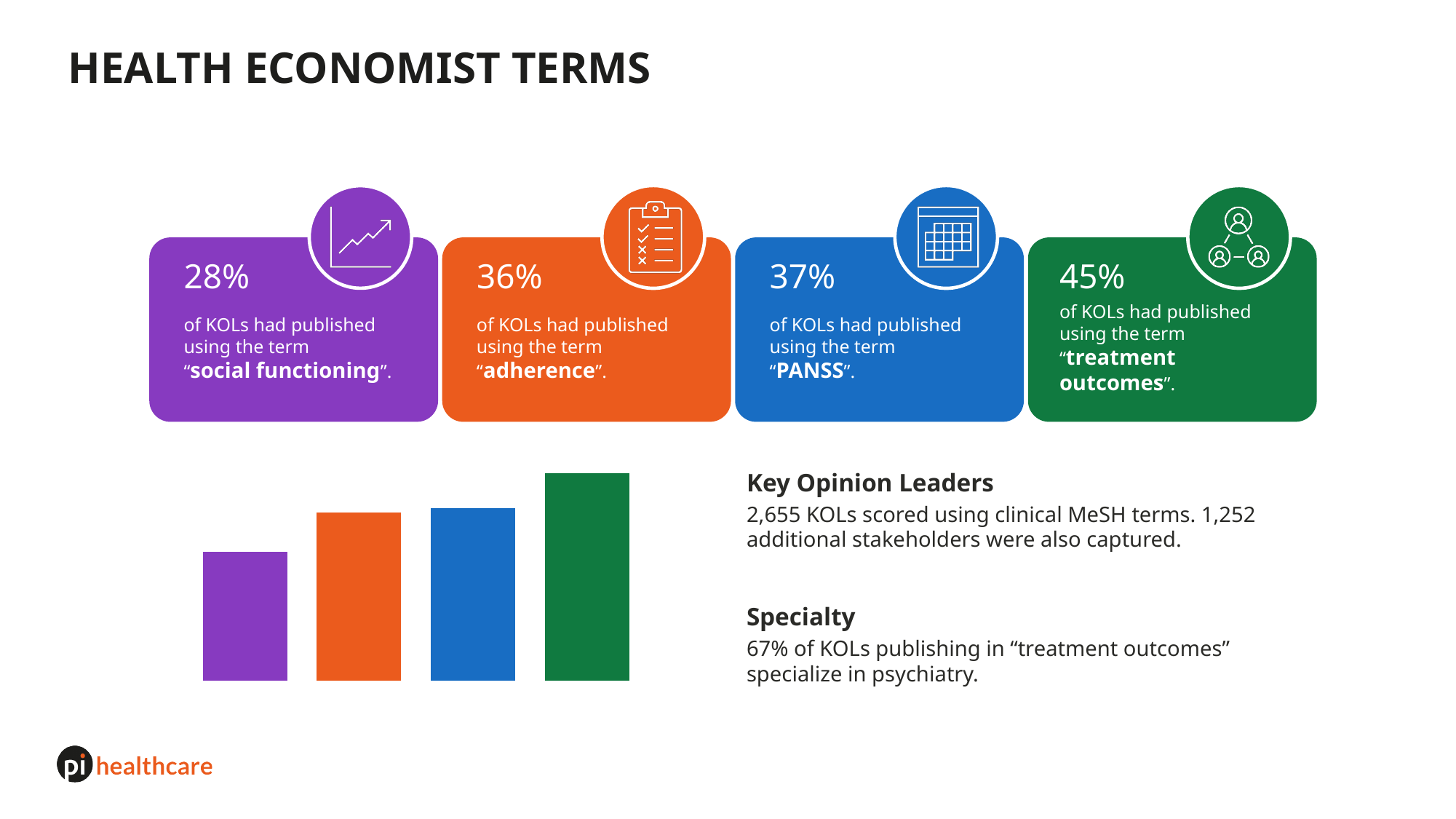
What colour is the bar representing the term "PANSS"? blue What is the difference in percentage points between "treatment outcomes" and "social functioning"? 17 percentage points How many bars does the bar chart contain? 4 What percentage does the green bar (treatment outcomes) represent? 45% What percentage does the purple bar (social functioning) represent? 28% What percentage of KOLs had published using the term "PANSS"? 37% Which term has the highest percentage of KOLs publishing with it? treatment outcomes Which term has the lowest percentage of KOLs publishing with it? social functioning Do the bars rise or fall from left to right in the bar chart? rise What kind of chart is shown at the bottom left of the slide? bar chart What percentage of KOLs had published using the term "adherence"? 36% Which is larger, the percentage for "adherence" or for "social functioning"? adherence